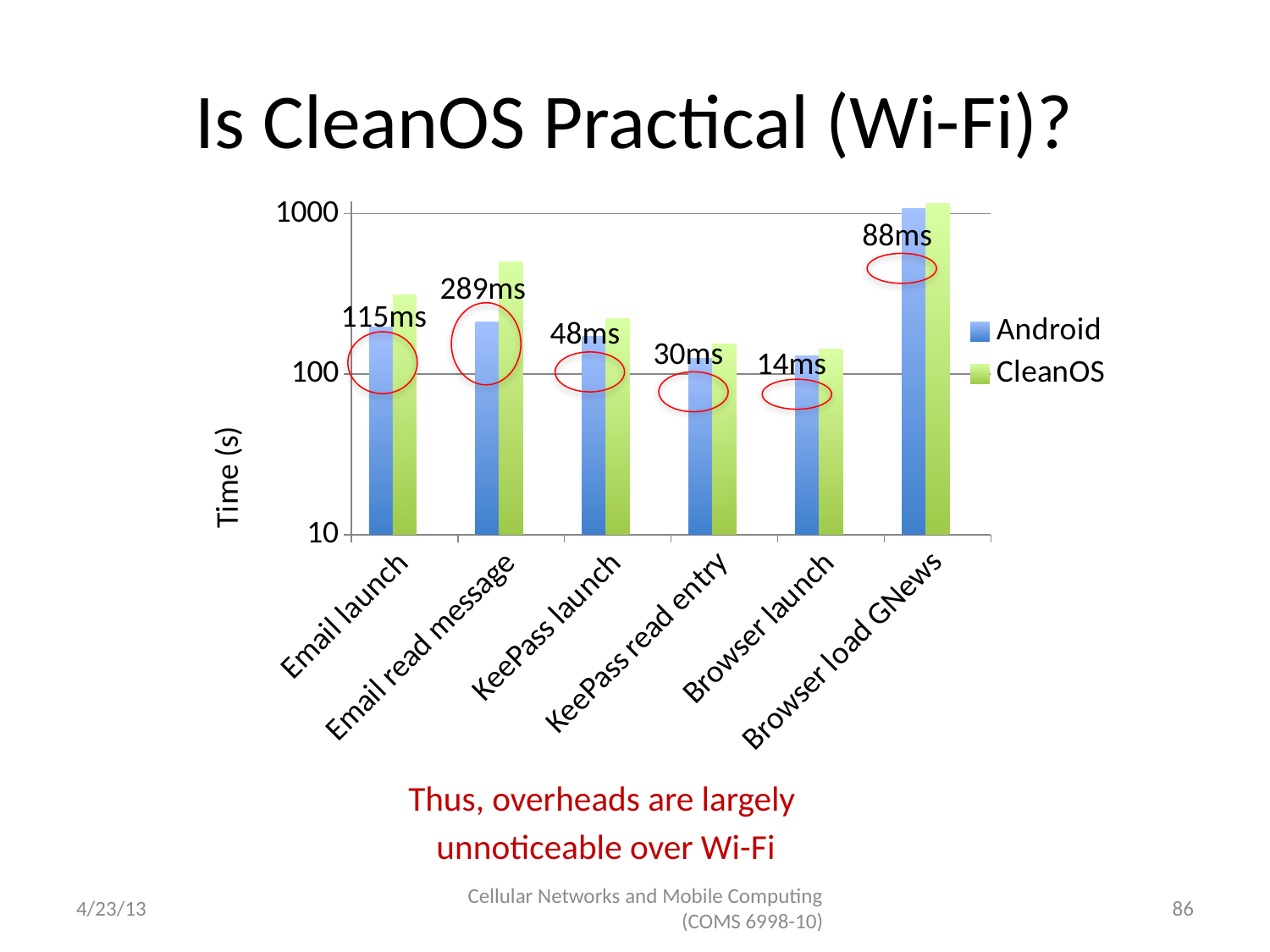
Which category has the highest CleanOS value? Browser load GNews How many series does the legend list? 2 What is the label of the y axis? Time (s) What overhead is annotated above the Email read message bars? 289ms For Email read message, which is larger, the Android value or the CleanOS value? CleanOS How many categories are shown on the x axis? 6 For the Android series, which is larger, Email launch or Email read message? Email read message Which category has the highest Android value? Browser load GNews Is the CleanOS value for Email read message greater or less than 1000? less What kind of chart is shown on the slide? bar chart Is the Android value for Email launch greater or less than 100? greater Is the CleanOS value for Browser load GNews greater or less than 1000? greater